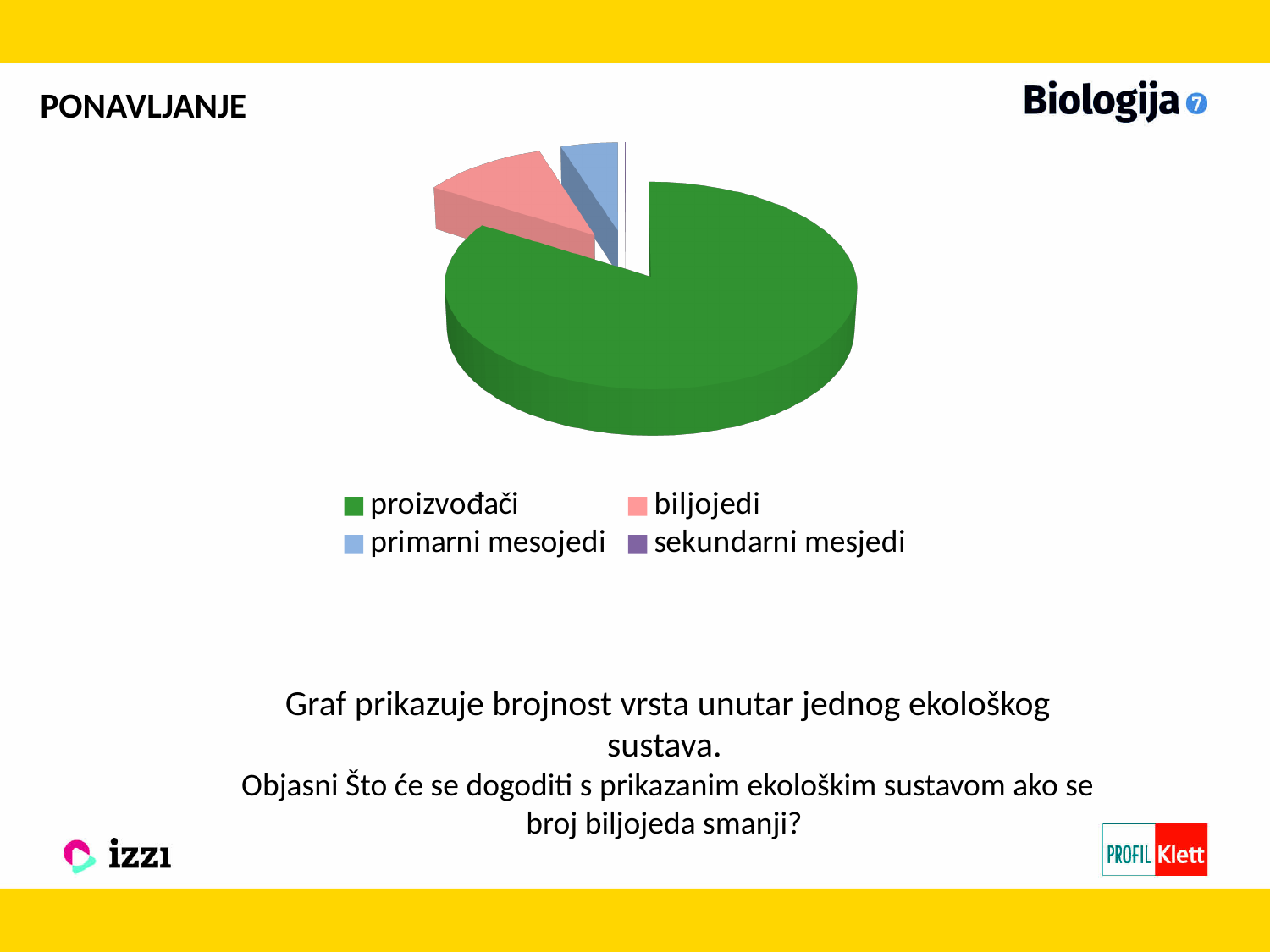
Which category has the smallest slice of the pie chart? sekundarni mesjedi Which slice is larger, proizvođači or biljojedi? proizvođači Which slice is larger, biljojedi or primarni mesojedi? biljojedi How many categories does the pie chart's legend list? 4 Which category has the largest slice of the pie chart? proizvođači Which category is shown in green in the pie chart? proizvođači Which slice is larger, primarni mesojedi or sekundarni mesjedi? primarni mesojedi What colour represents biljojedi in the pie chart? pink What kind of chart is shown on the slide? pie chart